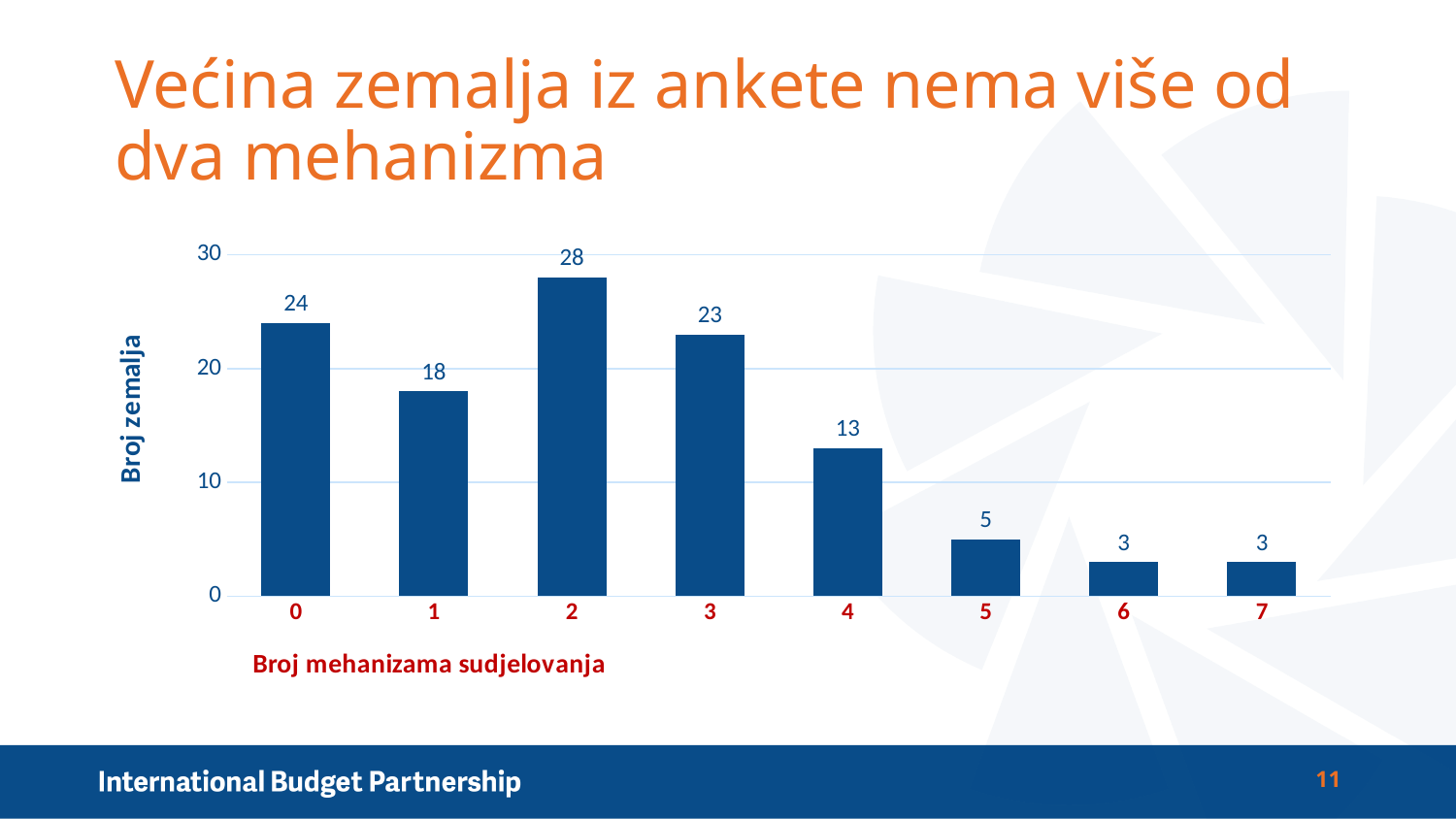
What is the value for category 0 on the x axis? 24 What is the label of the y axis? Broj zemalja How many categories are shown on the x axis? 8 Is the value for category 4 greater or less than 10? greater Do the values rise or fall from category 2 to category 7? fall What is the value for category 4 on the x axis? 13 What is the lowest value shown in the chart? 3 What is the difference between the values for category 2 and category 1? 10 Which number of mechanisms has the highest number of countries? 2 Which is larger, the value for category 0 or the value for category 3? category 0 How many countries have 2 participation mechanisms (Broj mehanizama sudjelovanja = 2)? 28 What kind of chart is shown on the slide? bar chart